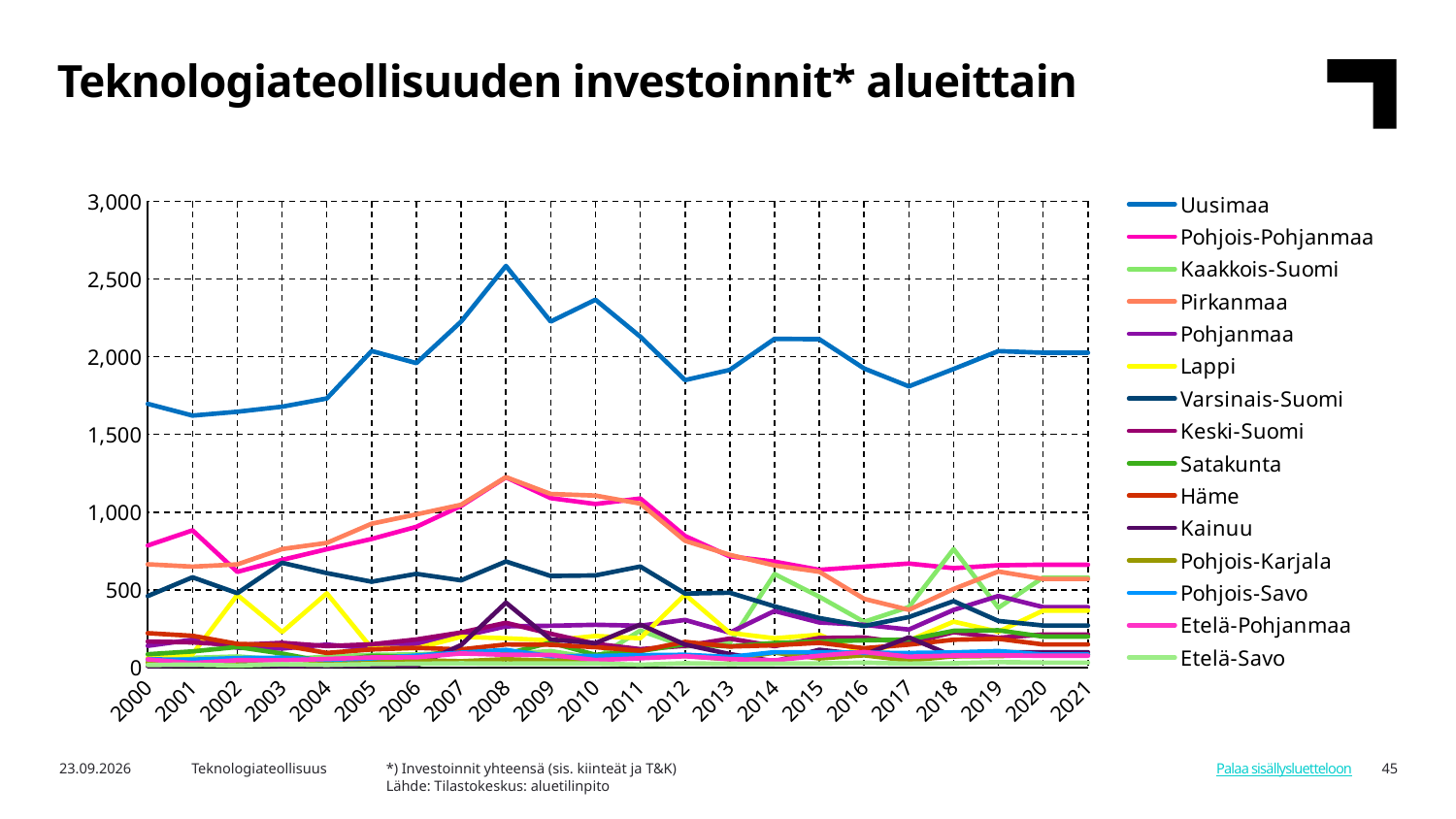
Is the value for Uusimaa in 2008 greater or less than 2,500? greater In which year does the Uusimaa line reach its peak? 2008 Does the Uusimaa line rise or fall between 2004 and 2008? rise Is the value for Pirkanmaa in 2008 greater or less than 1,000? greater Which region has the highest investment values across the whole period? Uusimaa What kind of chart is shown on the slide? line chart Is the value for Uusimaa in 2017 greater or less than 2,000? less How many years are plotted along the x axis? 22 How many series does the legend list? 15 What is the title of the chart on the slide? Teknologiateollisuuden investoinnit* alueittain Which is larger in 2010, the value for Uusimaa or the value for Pohjois-Pohjanmaa? Uusimaa